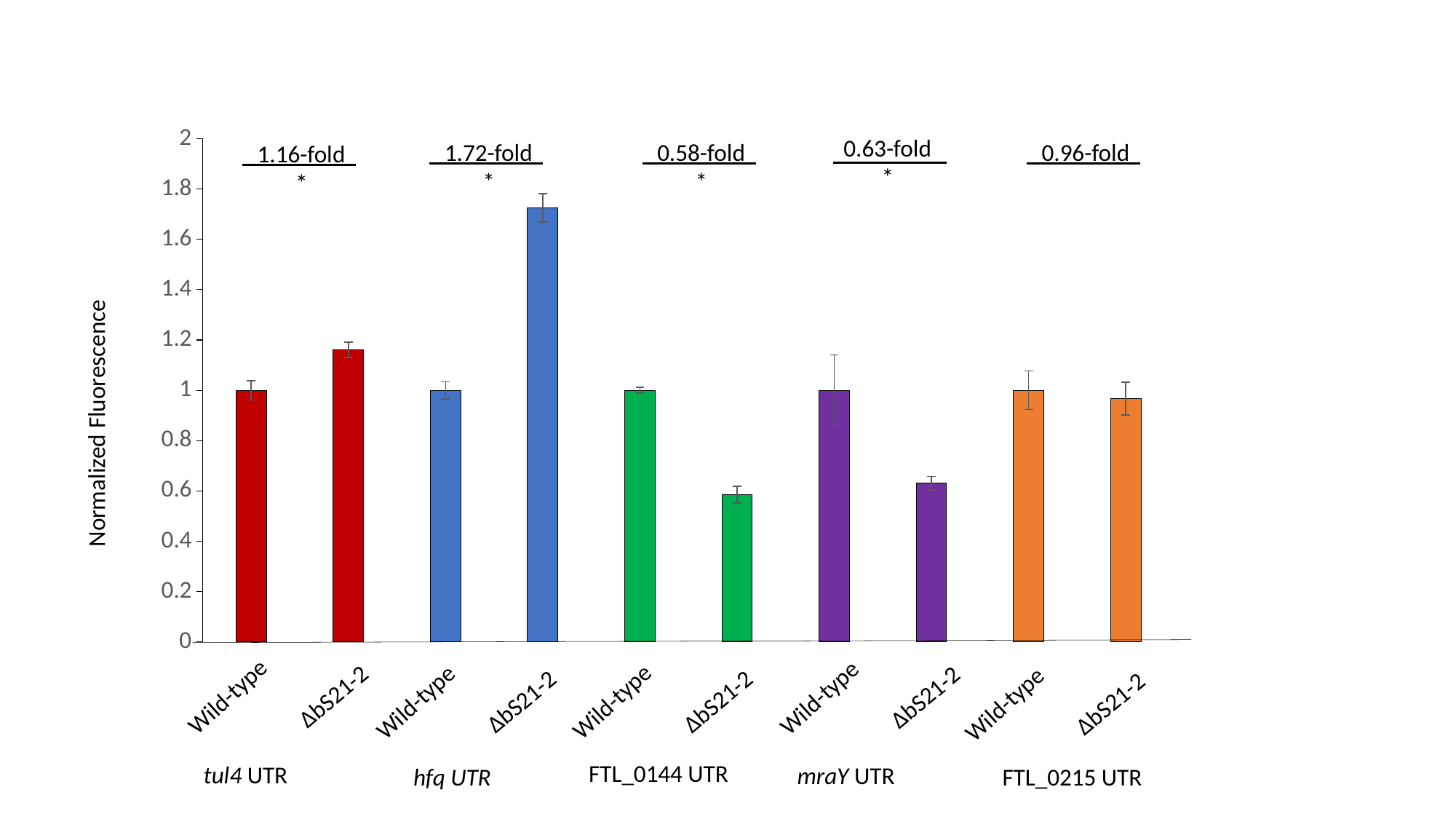
Which bar has the lowest Normalized Fluorescence? ΔbS21-2 in the FTL_0144 UTR group How many bars are plotted in the chart? 10 What is the label of the y-axis? Normalized Fluorescence What is the Normalized Fluorescence value for the Wild-type bar in the tul4 UTR group? 1 Is the Normalized Fluorescence for ΔbS21-2 in the hfq UTR group greater or less than 1.6? greater Which bar has the highest Normalized Fluorescence? ΔbS21-2 in the hfq UTR group What fold change is annotated above the FTL_0215 UTR group? 0.96-fold What fold change is annotated above the hfq UTR group? 1.72-fold Is the Normalized Fluorescence for ΔbS21-2 in the mraY UTR group greater or less than 0.8? less In the tul4 UTR group, which bar is taller, Wild-type or ΔbS21-2? ΔbS21-2 What kind of chart is shown on the slide? Bar chart How many UTR groups are shown along the x-axis? 5